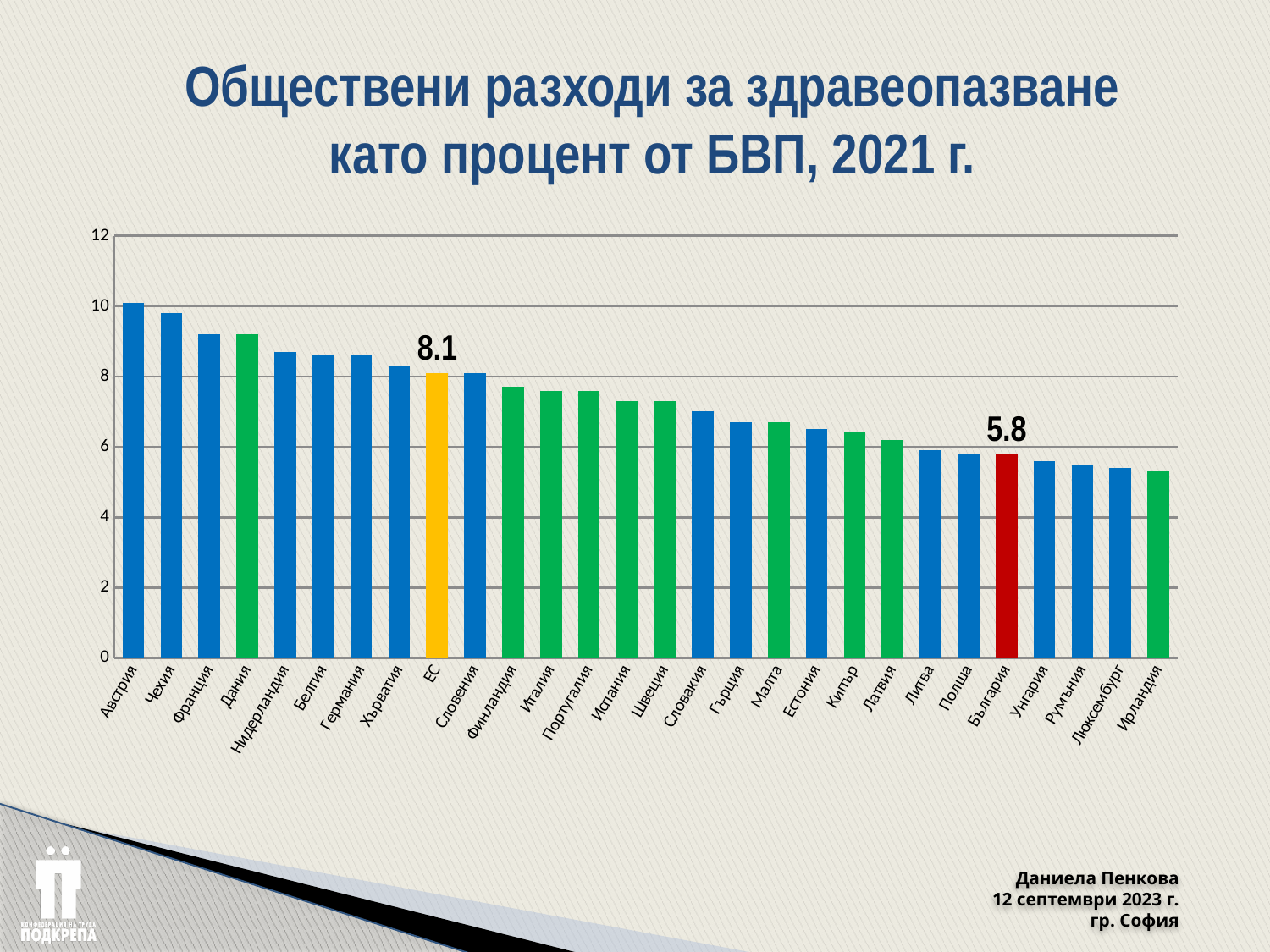
Is the value for Ирландия greater or less than 6? less Is the value for Дания greater or less than 8? greater Which has a larger value, Австрия or Ирландия? Австрия What is the value for България? 5.8 Do the values rise or fall from left to right along the x axis? fall What kind of chart is shown on the slide? bar chart Which country has the lowest value? Ирландия Which country has the highest value? Австрия What is the value for ЕС? 8.1 What colour is the bar for България? red What is the difference between the value for ЕС and the value for България? 2.3 How many categories are shown on the x axis? 28